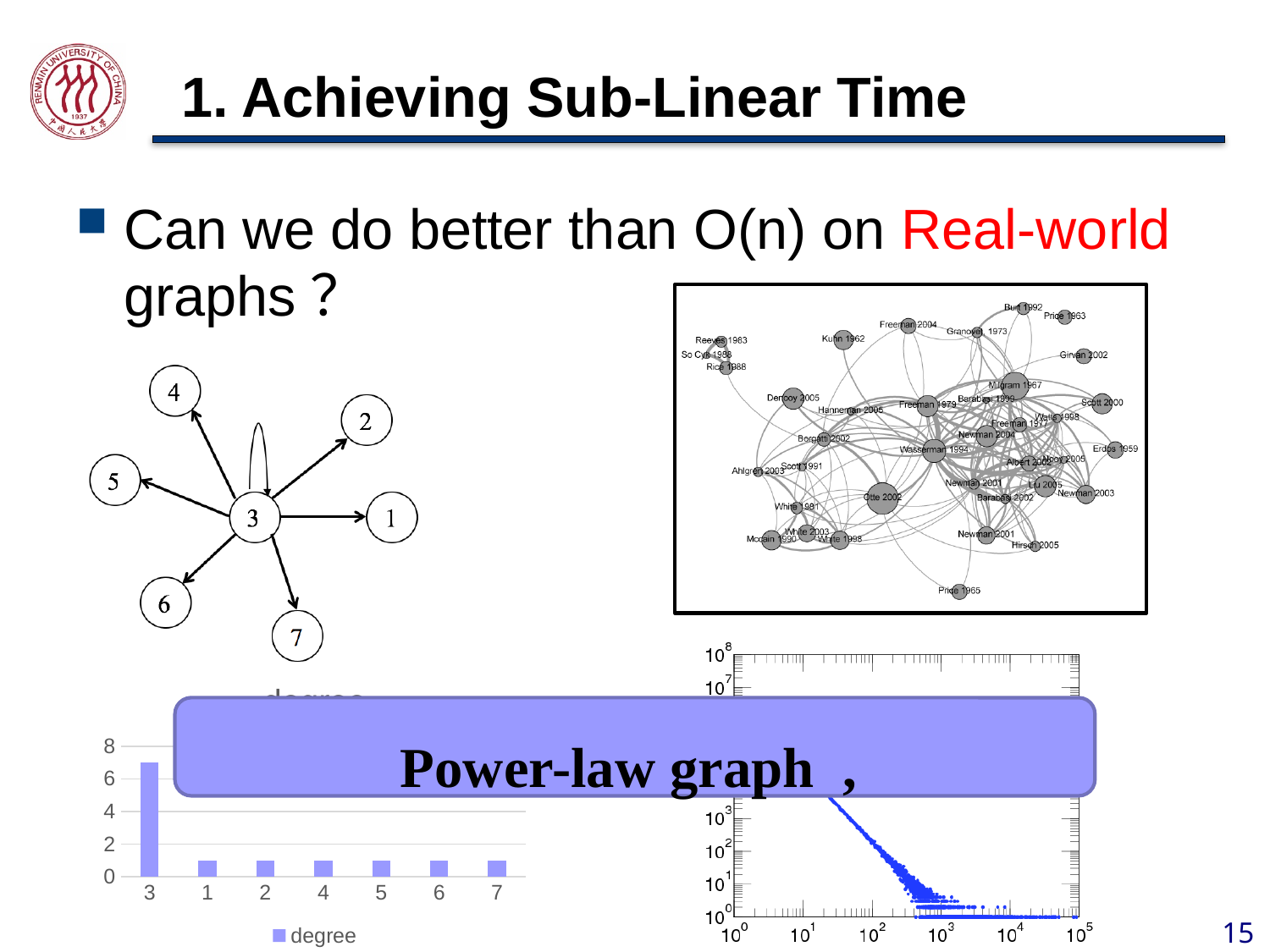
What kind of chart is the chart at the bottom right of the slide? scatter chart In the bar chart at the bottom left, how many series does the legend list? 1 In the bar chart at the bottom left, which has the larger value, category 3 or category 5? 3 In the bar chart at the bottom left, is the value for category 3 greater or less than 6? greater In the bar chart at the bottom left, how many categories are shown on the x axis? 7 In the bar chart at the bottom left, what is the name of the series shown in the legend? degree What kind of chart is the chart at the bottom left of the slide? bar chart In the bar chart at the bottom left, which category has the highest bar? 3 In the bar chart at the bottom left, is the value for category 1 greater or less than 2? less In the bar chart at the bottom left, what is the highest tick label on the y axis? 8 In the scatter chart at the bottom right, do the plotted values rise or fall as the x axis increases? fall In the bar chart at the bottom left, is the value for category 3 greater or less than 8? less